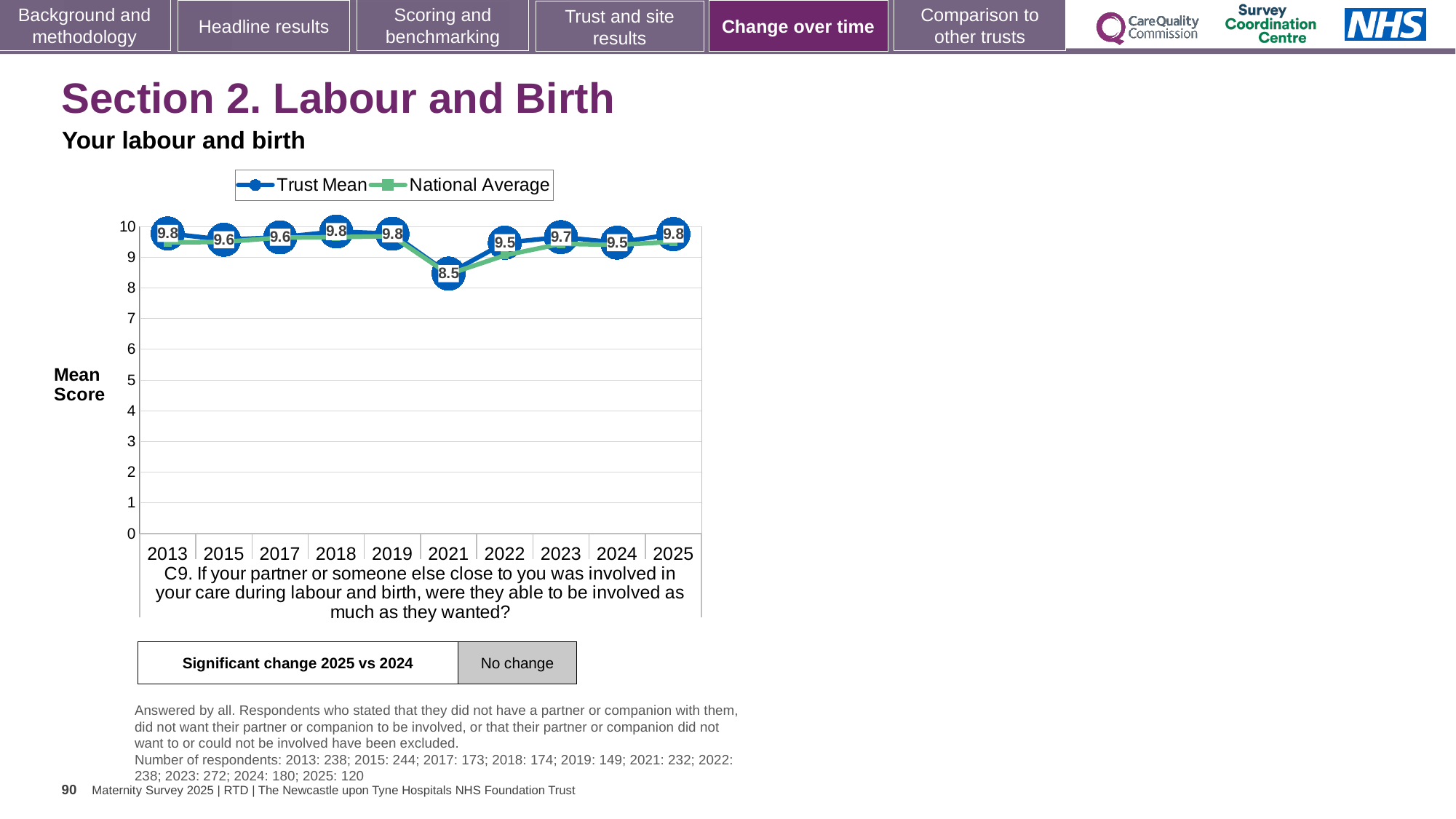
What is the difference between the Trust Mean scores for 2019 and 2021? 1.3 Which year has the larger Trust Mean score, 2021 or 2022? 2022 What is the Trust Mean score for 2025? 9.8 What kind of chart is shown on the slide? Line chart What are the two series named in the legend? Trust Mean and National Average Is the National Average value for 2013 greater or less than 9? greater What is the Trust Mean score for 2021? 8.5 In which year is the Trust Mean score lowest? 2021 How many series does the legend list? 2 Does the Trust Mean score rise or fall from 2019 to 2021? Fall What is the Trust Mean score for 2023? 9.7 How many years are plotted on the x axis? 10